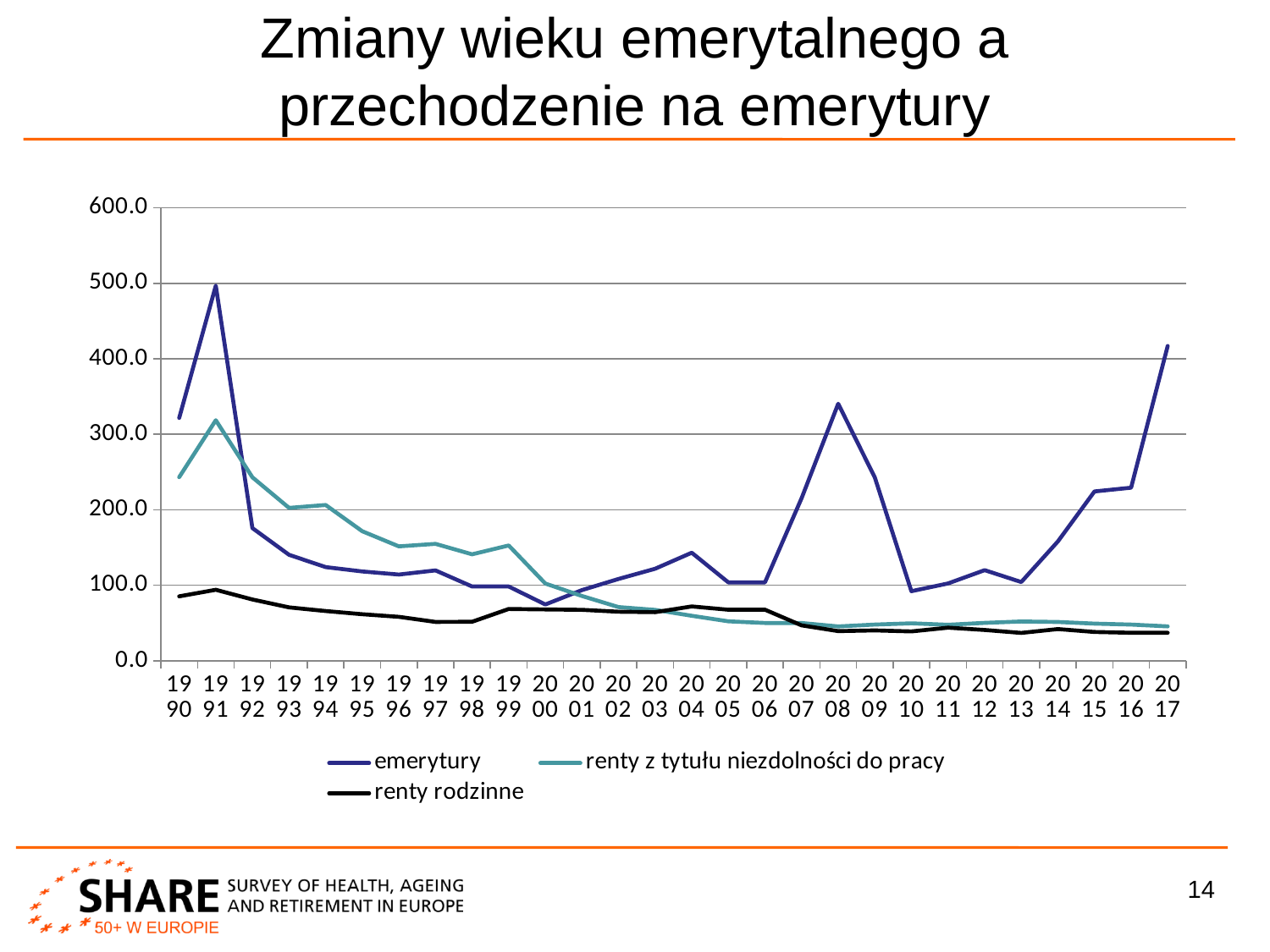
Which series is drawn with a black line? renty rodzinne What kind of chart is shown on the slide? line chart What is the title of the slide? Zmiany wieku emerytalnego a przechodzenie na emerytury Which series has the higher value in 2017, emerytury or renty rodzinne? emerytury Is the value for emerytury in 2008 greater or less than 300.0? greater Does the renty z tytułu niezdolności do pracy series generally rise or fall from 1991 to 2017? fall How many years are plotted along the x axis? 28 Is the value for renty z tytułu niezdolności do pracy in 1991 greater or less than 300.0? greater Is the value for emerytury in 1991 greater or less than 400.0? greater How many series does the legend list? 3 In which year does the emerytury series reach its highest value? 1991